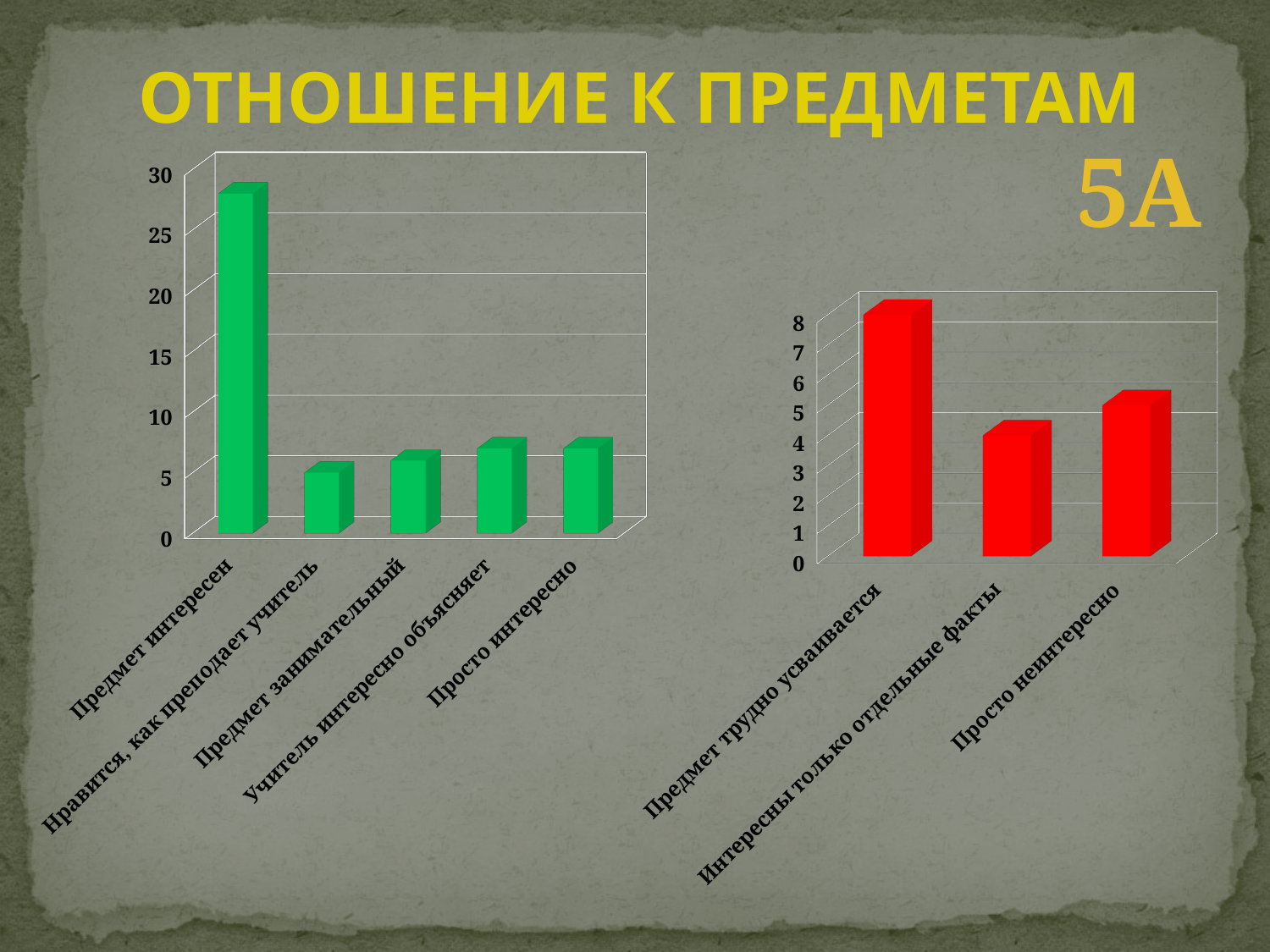
On the left (green) chart, is the value for Предмет интересен greater or less than 25? greater On the right (red) chart, which category has the lowest value? Интересны только отдельные факты On the left (green) chart, is the value for Учитель интересно объясняет greater or less than 10? less On the left (green) chart, which is larger: Предмет интересен or Просто интересно? Предмет интересен How many categories are shown on the left (green) chart? 5 What is the title of the slide above the charts? ОТНОШЕНИЕ К ПРЕДМЕТАМ On the right (red) chart, is the value for Интересны только отдельные факты greater or less than 6? less How many categories are shown on the right (red) chart? 3 On the left (green) chart, which category has the highest value? Предмет интересен What kind of chart is the right (red) chart? Bar chart On the right (red) chart, which category has the highest value? Предмет трудно усваивается